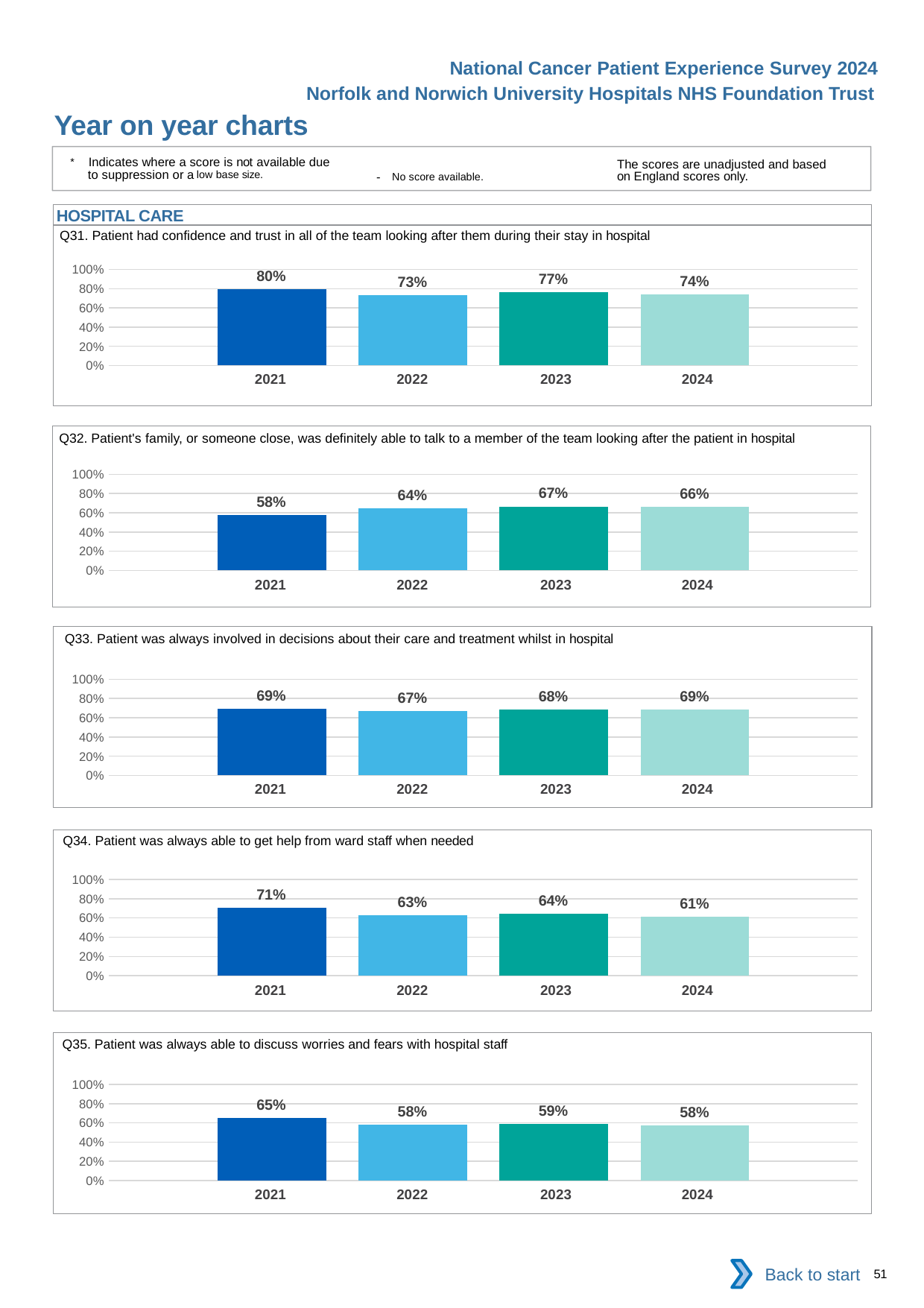
In the Q34 chart, does the value rise or fall from 2021 to 2022? Fall In the Q31 chart, which is larger, the value for 2022 or the value for 2023? 2023 What type of chart is used for Q32? Bar chart In the Q35 chart (patient was always able to discuss worries and fears), which year has the highest value? 2021 How many years are shown in the Q34 chart? 4 In the Q35 chart, what is the value for 2023? 59% In the Q33 chart (patient was always involved in decisions about their care), what is the value for 2022? 67% In the Q32 chart (patient's family was definitely able to talk to a member of the team), which year has the lowest value? 2021 How many charts are shown under the HOSPITAL CARE section on this slide? 5 In the Q34 chart (patient was always able to get help from ward staff), what is the difference between the 2021 and 2024 values? 10 percentage points In the Q32 chart, is the value for 2021 greater or less than 60%? less In the Q31 chart (patient had confidence and trust in all of the team), what is the value for 2021? 80%